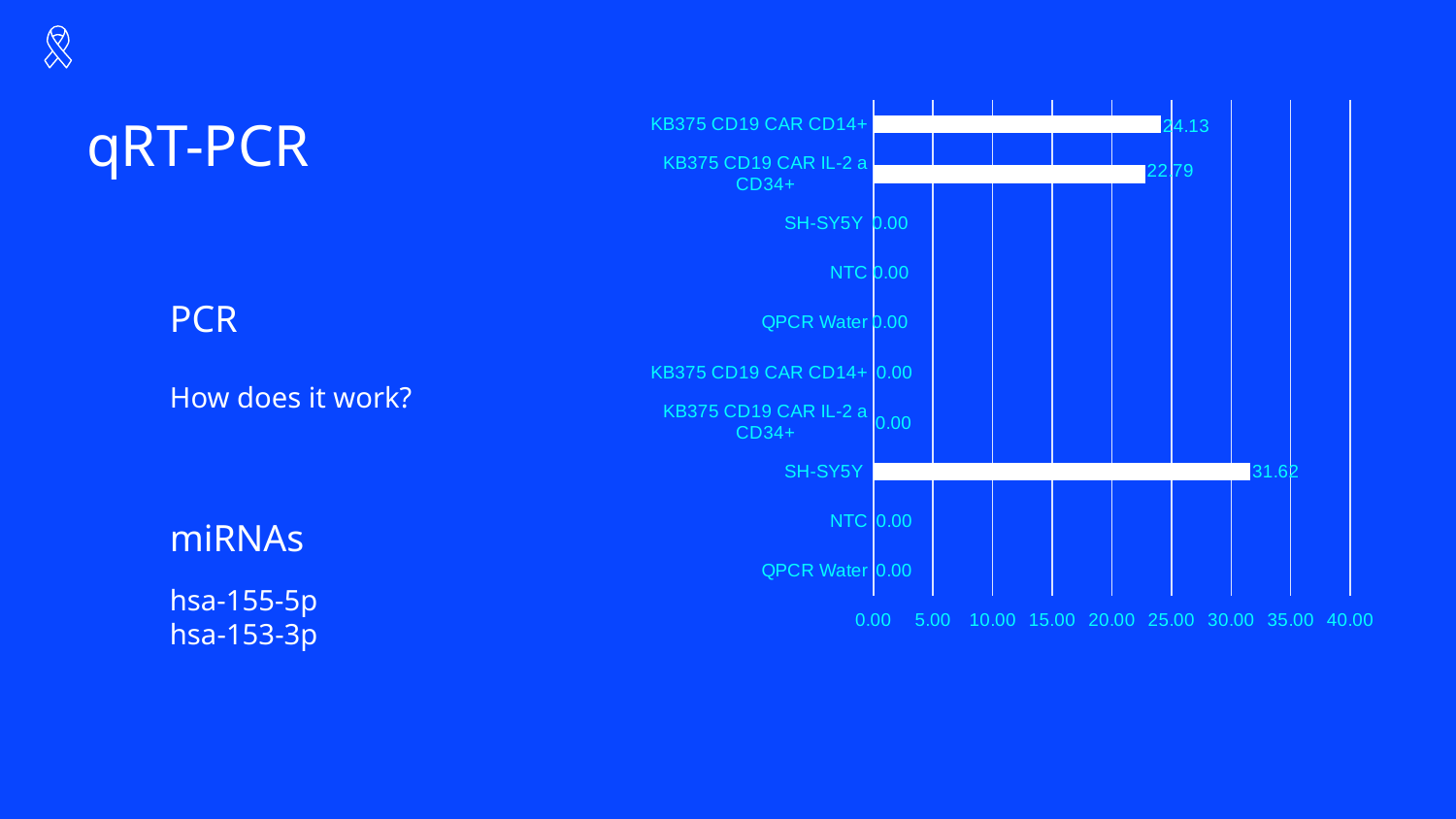
How many bars (categories) are plotted in the chart? 10 How many bars in the chart have a value of 0.00? 7 What kind of chart is shown on the slide? bar chart Is the value of the SH-SY5Y bar in the lower group greater or less than 30.00? greater What is the value of the second bar from the top, labelled KB375 CD19 CAR IL-2 a CD34+? 22.79 What is the value of the SH-SY5Y bar in the lower group of categories? 31.62 What is the largest tick value shown on the horizontal axis? 40.00 What is the difference between the highest value (31.62) and the topmost bar's value (24.13)? 7.49 Which category has the highest value in the chart? SH-SY5Y (lower group) What is the difference between the topmost KB375 CD19 CAR CD14+ bar (24.13) and the KB375 CD19 CAR IL-2 a CD34+ bar directly below it (22.79)? 1.34 What is the value of the topmost bar, labelled KB375 CD19 CAR CD14+? 24.13 In the top group, which is larger: the KB375 CD19 CAR CD14+ bar or the KB375 CD19 CAR IL-2 a CD34+ bar? KB375 CD19 CAR CD14+